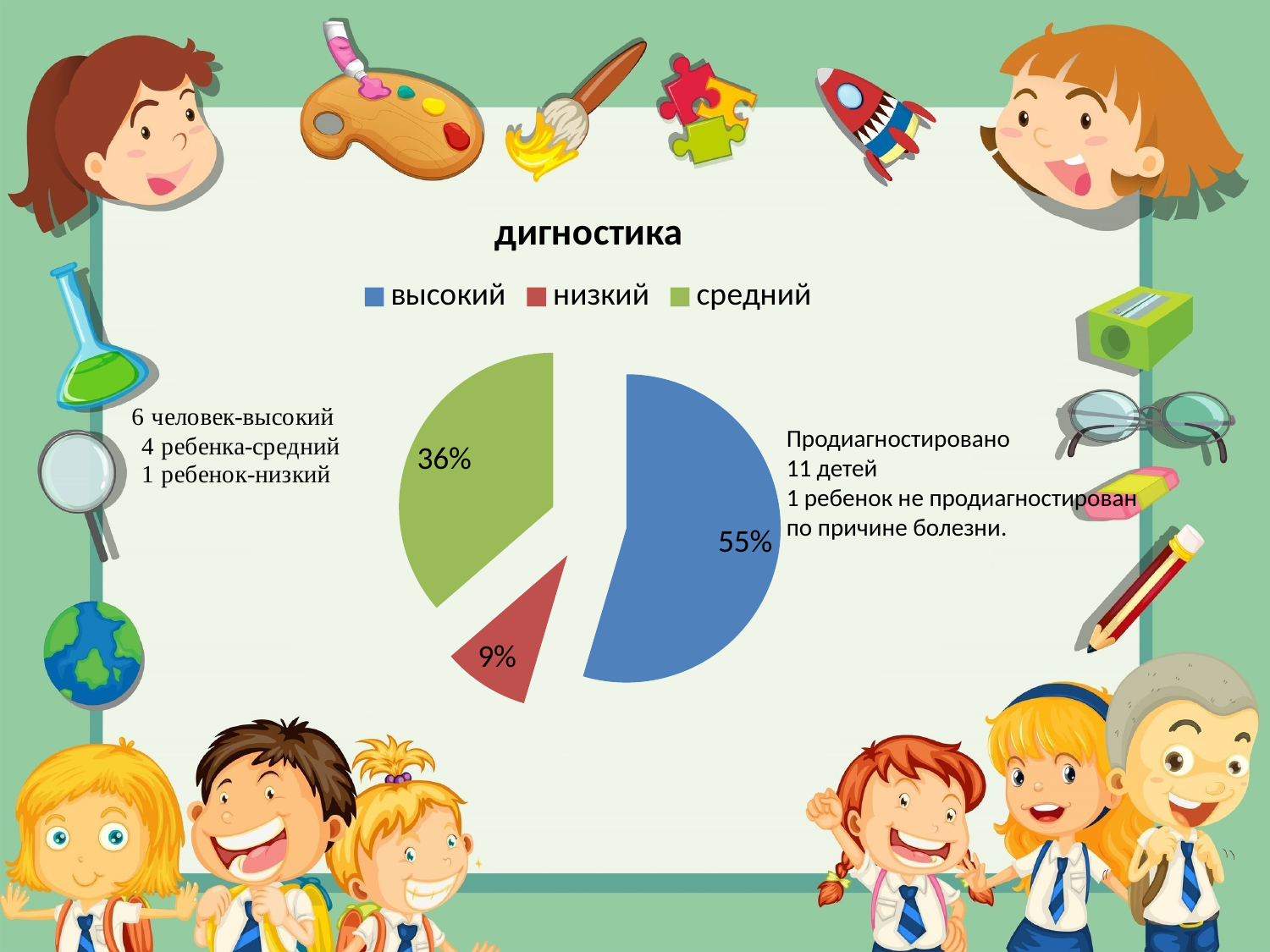
What share of the pie does the 'средний' slice represent? 36% Which slice is larger, 'средний' or 'низкий'? средний What is the difference in percentage points between the 'средний' and 'низкий' slices? 27% What kind of chart is shown on the slide? pie chart What is the difference in percentage points between the 'высокий' and 'средний' slices? 19% What colour is the 'низкий' slice in the pie chart? red What share of the pie does the 'высокий' slice represent? 55% Which category has the smallest slice of the pie? низкий Which category has the largest slice of the pie? высокий What is the title of the chart? дигностика How many categories does the legend of the pie chart list? 3 What share of the pie does the 'низкий' slice represent? 9%